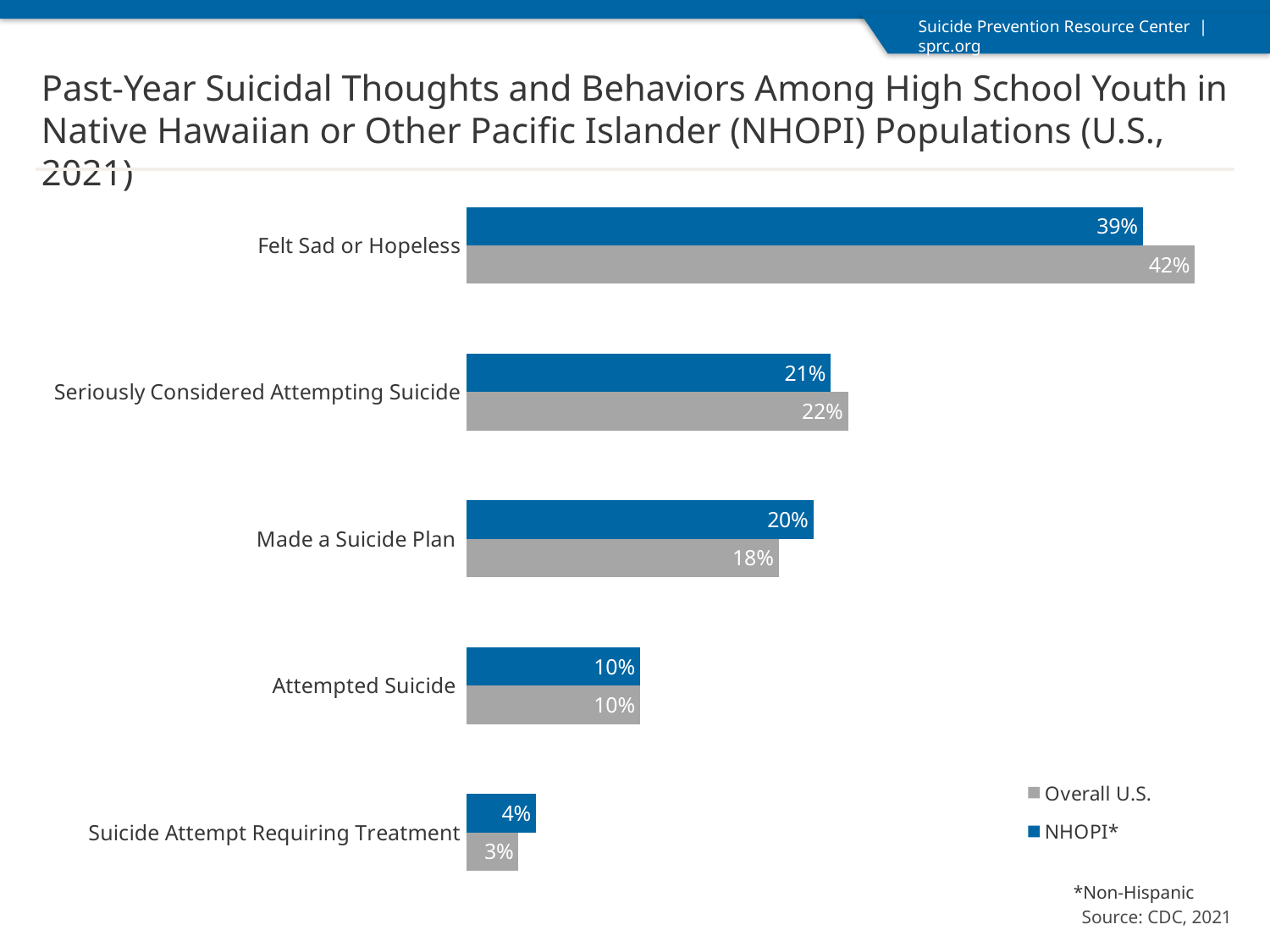
What kind of chart is shown on the slide? Bar chart What is the difference between the NHOPI and Overall U.S. values for Made a Suicide Plan? 2% Which category has the highest NHOPI value? Felt Sad or Hopeless What is the difference between the Overall U.S. and NHOPI values for Felt Sad or Hopeless? 3% What is the NHOPI value for Suicide Attempt Requiring Treatment? 4% What is the NHOPI value for Felt Sad or Hopeless? 39% How many series does the legend list? 2 For Seriously Considered Attempting Suicide, which is larger: the NHOPI value or the Overall U.S. value? Overall U.S. Which category has the lowest Overall U.S. value? Suicide Attempt Requiring Treatment What is the Overall U.S. value for Felt Sad or Hopeless? 42% What is the Overall U.S. value for Made a Suicide Plan? 18% How many categories are shown in the chart? 5